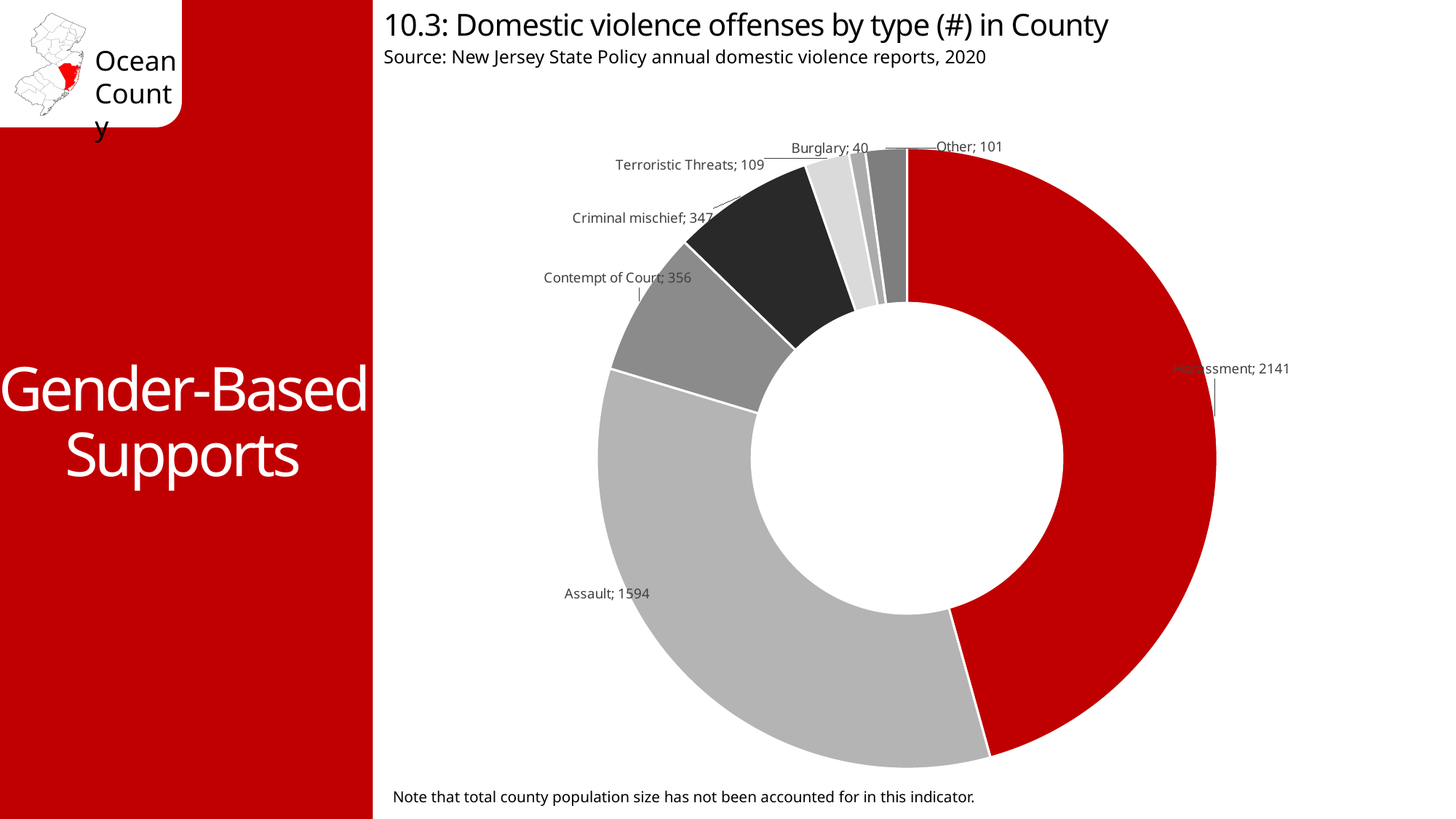
What is the difference between the Other and Burglary values? 61 Which is larger, Contempt of Court or Criminal mischief? Contempt of Court What is the difference between the Harassment and Assault values? 547 What is the value for Contempt of Court? 356 What is the value for Assault? 1594 What is the title of the chart? 10.3: Domestic violence offenses by type (#) in County How many offense categories are shown in the chart? 7 What is the value for Burglary? 40 Which offense type has the lowest number of offenses? Burglary Which offense type has the highest number of offenses? Harassment What type of chart is shown on the slide? Donut (pie) chart How many domestic violence offenses of type Harassment are shown? 2141